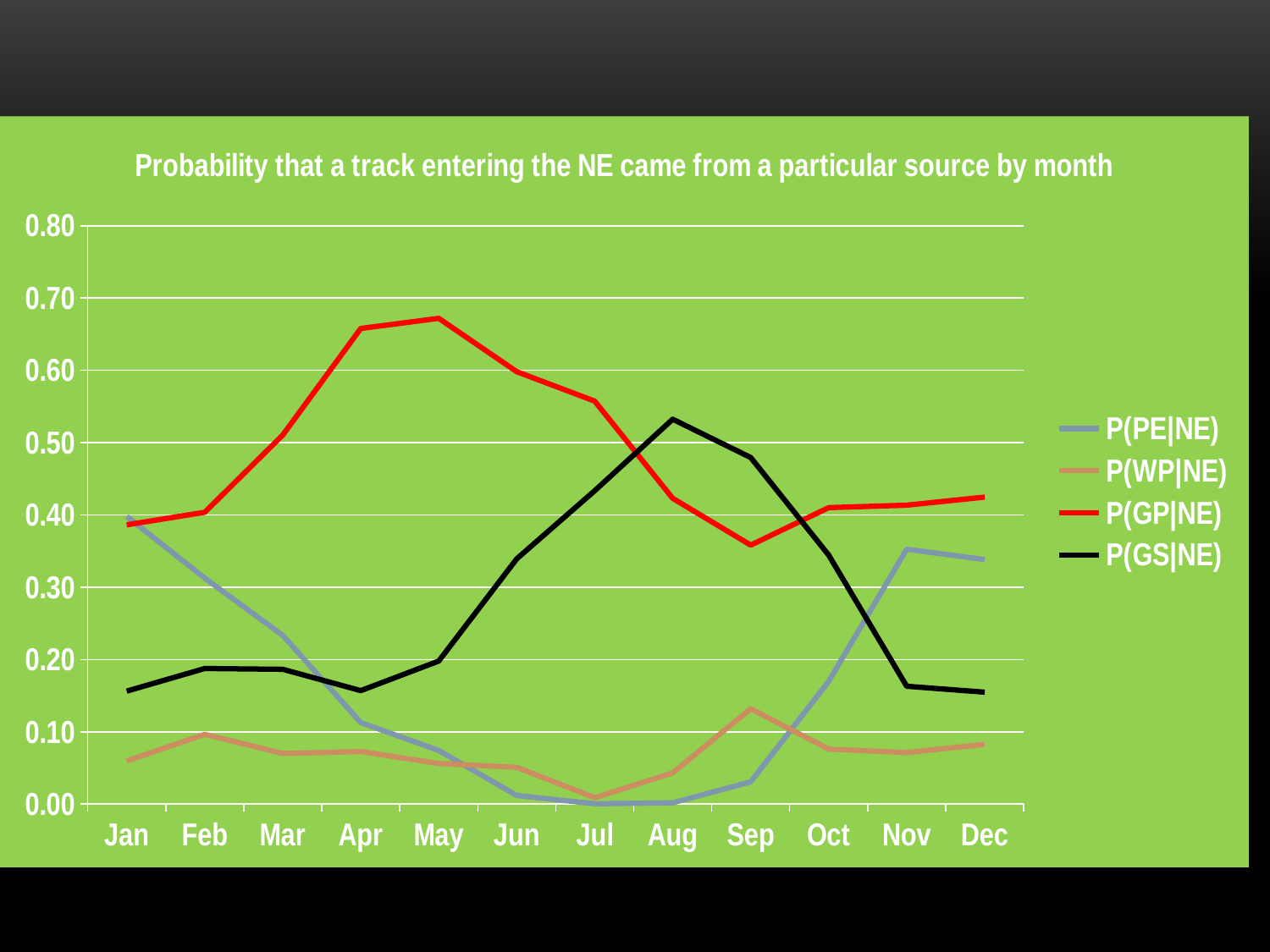
What is the title of the chart? Probability that a track entering the NE came from a particular source by month What kind of chart is shown on the slide? line chart In which month is P(GS|NE) highest? Aug In Jan, which is larger: P(PE|NE) or P(GS|NE)? P(PE|NE) Does P(GS|NE) rise or fall from Apr to Aug? rise In Aug, which series has the highest value? P(GS|NE) How many months are plotted along the x axis? 12 Is the value of P(WP|NE) in Sep greater or less than 0.10? greater How many series does the legend list? 4 In which month is P(GP|NE) lowest? Sep Is the value of P(GP|NE) in May greater or less than 0.60? greater Is the value of P(GS|NE) in Aug greater or less than 0.50? greater